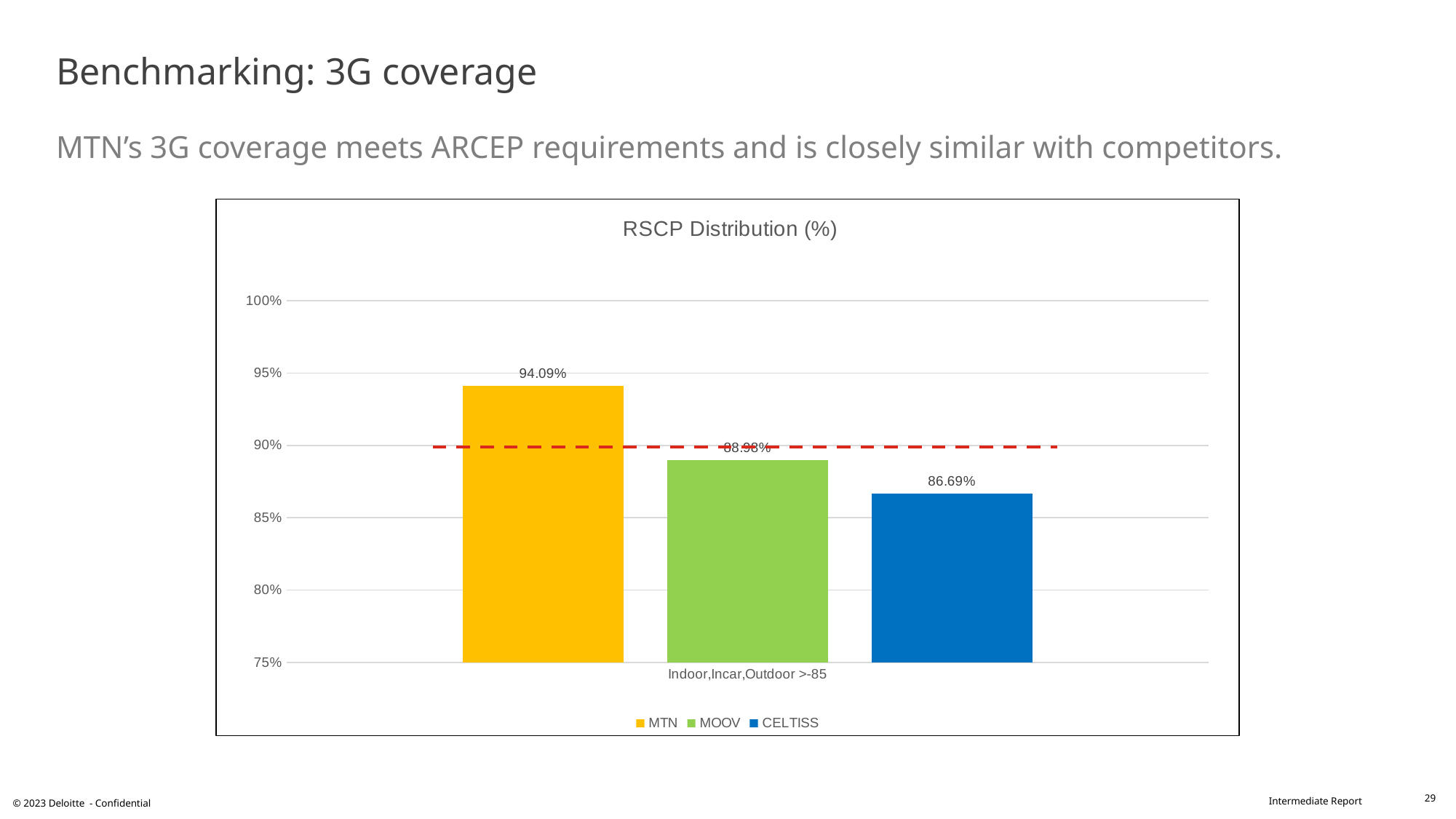
What is the category label on the x axis of the RSCP Distribution (%) chart? Indoor,Incar,Outdoor >-85 Which operator has the highest value in the RSCP Distribution (%) chart? MTN Which operator has the lowest value in the RSCP Distribution (%) chart? CELTISS Which is larger in the RSCP Distribution (%) chart, the value for MOOV or the value for CELTISS? MOOV What colour is the MTN bar in the RSCP Distribution (%) chart? Yellow What kind of chart is the RSCP Distribution (%) chart? Bar chart What is the value for CELTISS in the RSCP Distribution (%) chart? 86.69% What is the value for MTN in the RSCP Distribution (%) chart? 94.09% Is the value for MTN in the RSCP Distribution (%) chart greater or less than 90%? greater Is the value for MOOV in the RSCP Distribution (%) chart greater or less than 90%? less What is the difference between the MTN and CELTISS values in the RSCP Distribution (%) chart? 7.40% How many series does the legend of the RSCP Distribution (%) chart list? 3